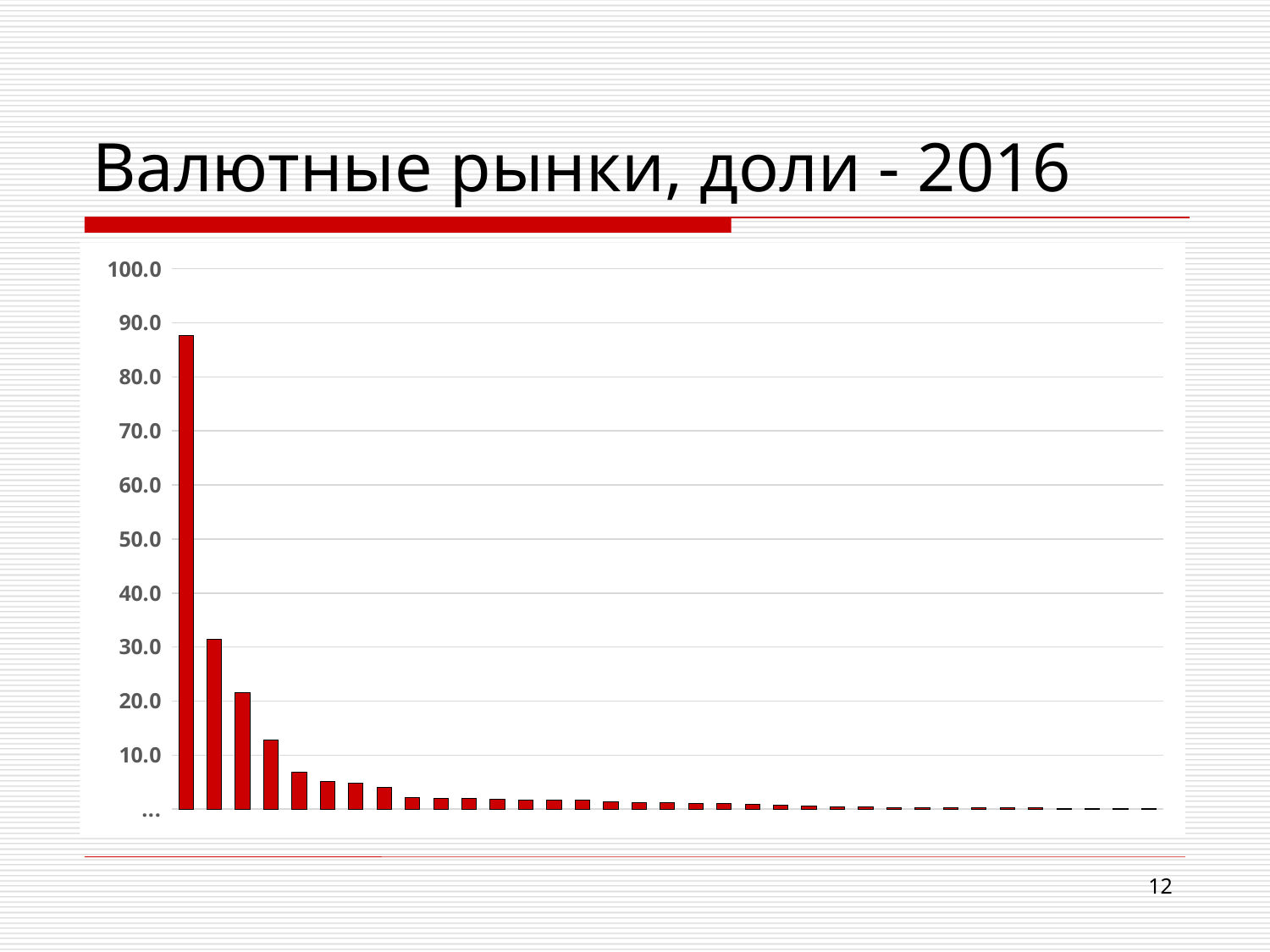
Is the value of the first (leftmost) bar greater or less than 80.0? greater Which is larger, the second bar from the left or the third bar from the left? the second bar from the left What is the title of the chart on the slide? Валютные рынки, доли - 2016 Which bar is the tallest in the chart? the first (leftmost) bar Is the value of the fourth bar from the left greater or less than 10.0? greater Is the value of the fifth bar from the left greater or less than 10.0? less What kind of chart is shown on the slide? bar chart Do the bar values rise or fall moving from left to right along the x axis? fall What is the highest value shown on the vertical axis of the chart? 100.0